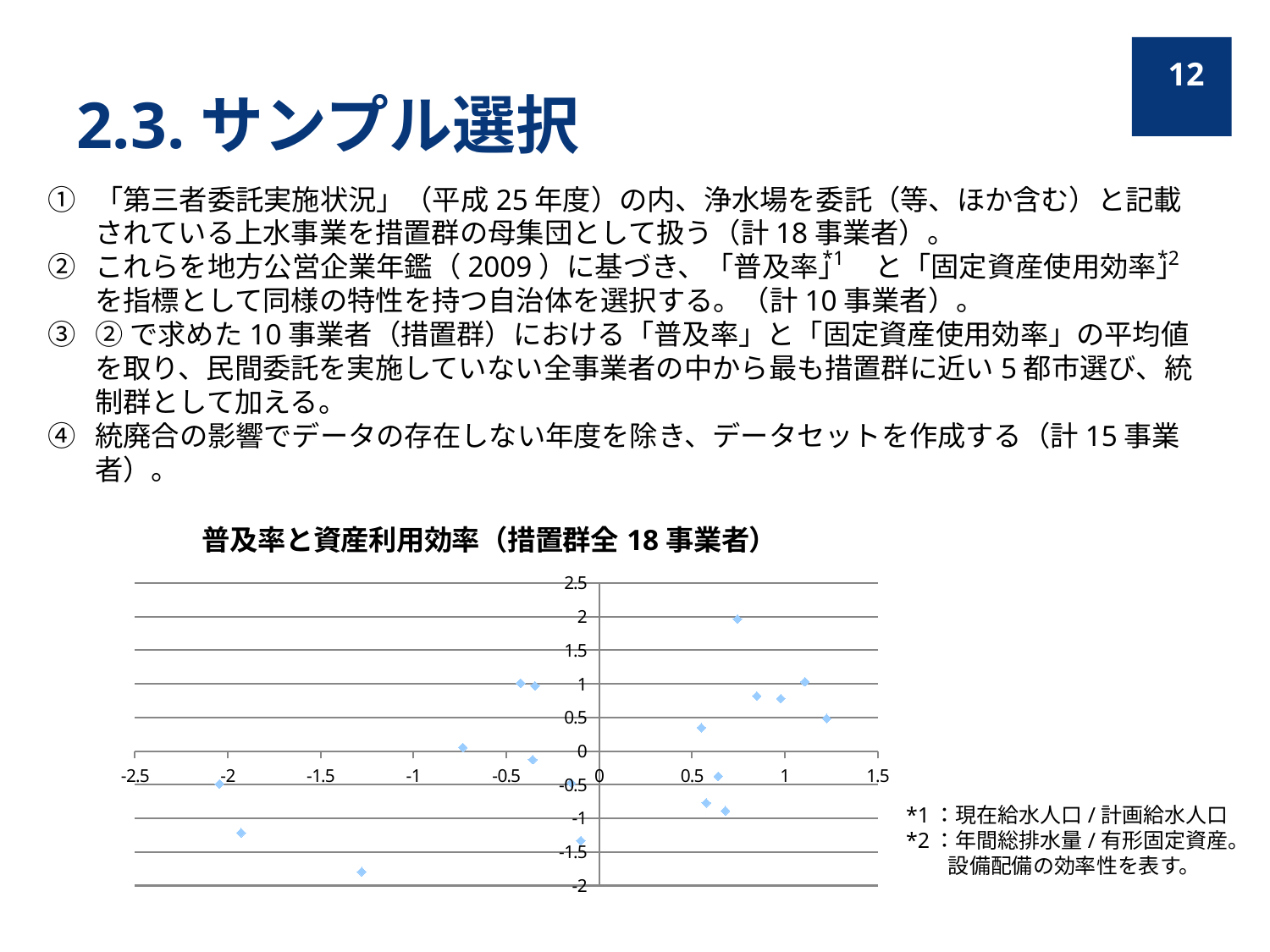
Is the y value of the highest point on the chart greater or less than 1? greater What kind of chart is shown on the slide? scatter chart Is the y value of the lowest point on the chart greater or less than -1? less Is the y value of the highest point on the chart greater or less than 1.5? greater What is the title of the chart? 普及率と資産利用効率（措置群全 18 事業者） According to the chart title, how many businesses (事業者) are in the treatment group plotted? 18